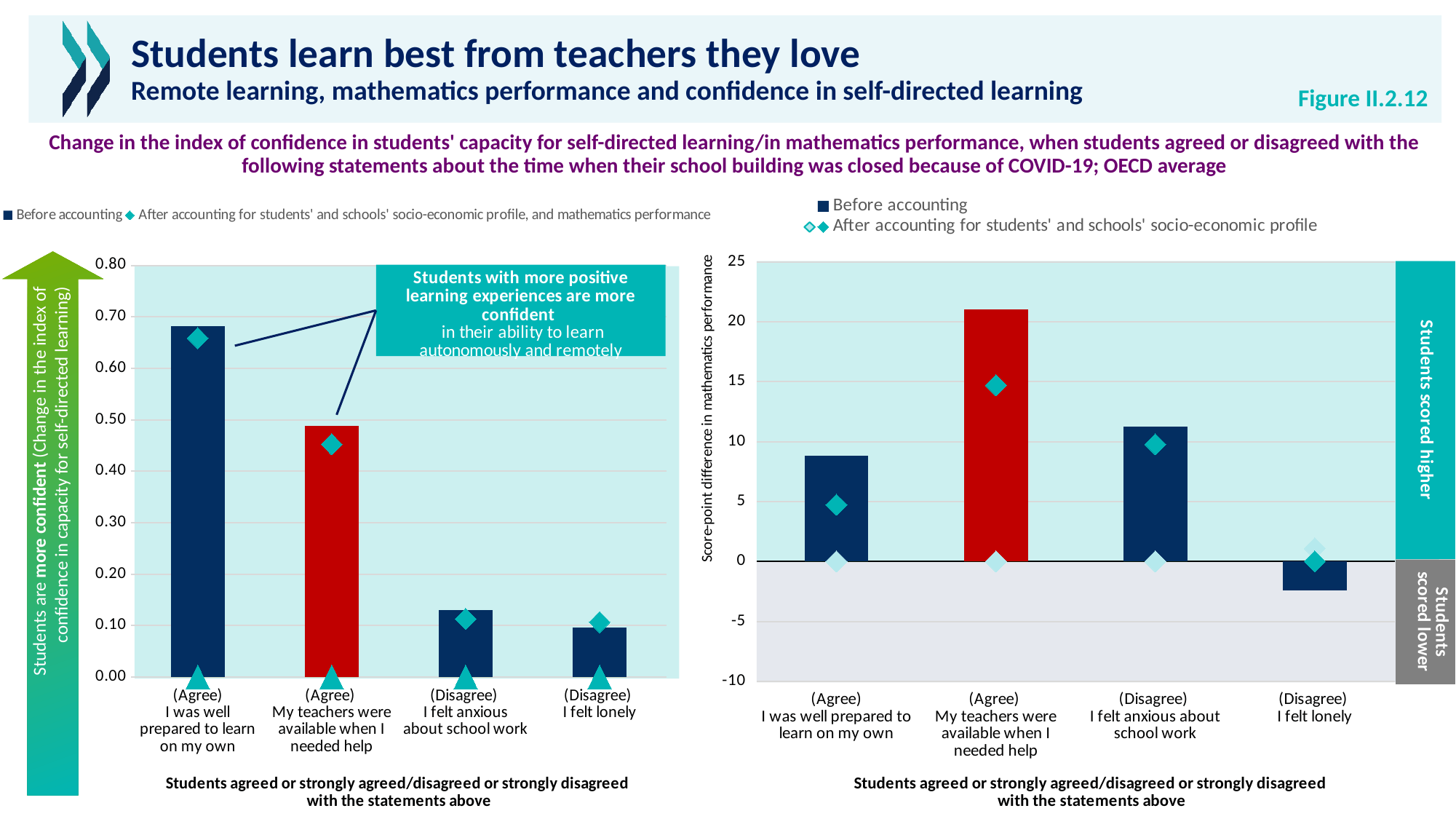
In the left chart (confidence in self-directed learning), is the 'Before accounting' value for '(Agree) My teachers were available when I needed help' greater or less than 0.40? greater In the right chart (score-point difference in mathematics performance), which has the larger 'Before accounting' bar: '(Agree) I was well prepared to learn on my own' or '(Disagree) I felt anxious about school work'? (Disagree) I felt anxious about school work What kind of chart is the left chart (change in the index of confidence in capacity for self-directed learning)? bar chart In the left chart (confidence in self-directed learning), which statement has the highest 'Before accounting' bar? (Agree) I was well prepared to learn on my own How many series does the legend of the right chart (score-point difference in mathematics performance) list? 2 How many statement categories are shown on the x axis of the left chart (confidence in self-directed learning)? 4 In the left chart (confidence in self-directed learning), which statement has the lowest 'Before accounting' bar? (Disagree) I felt lonely In the right chart (score-point difference in mathematics performance), is the 'Before accounting' value for '(Disagree) I felt lonely' greater or less than 0? less In the right chart (score-point difference in mathematics performance), is the 'Before accounting' value for '(Agree) My teachers were available when I needed help' greater or less than 15? greater In the right chart (score-point difference in mathematics performance), which statement has the highest 'Before accounting' bar? (Agree) My teachers were available when I needed help In the right chart (score-point difference in mathematics performance), which statement has the lowest 'Before accounting' bar? (Disagree) I felt lonely